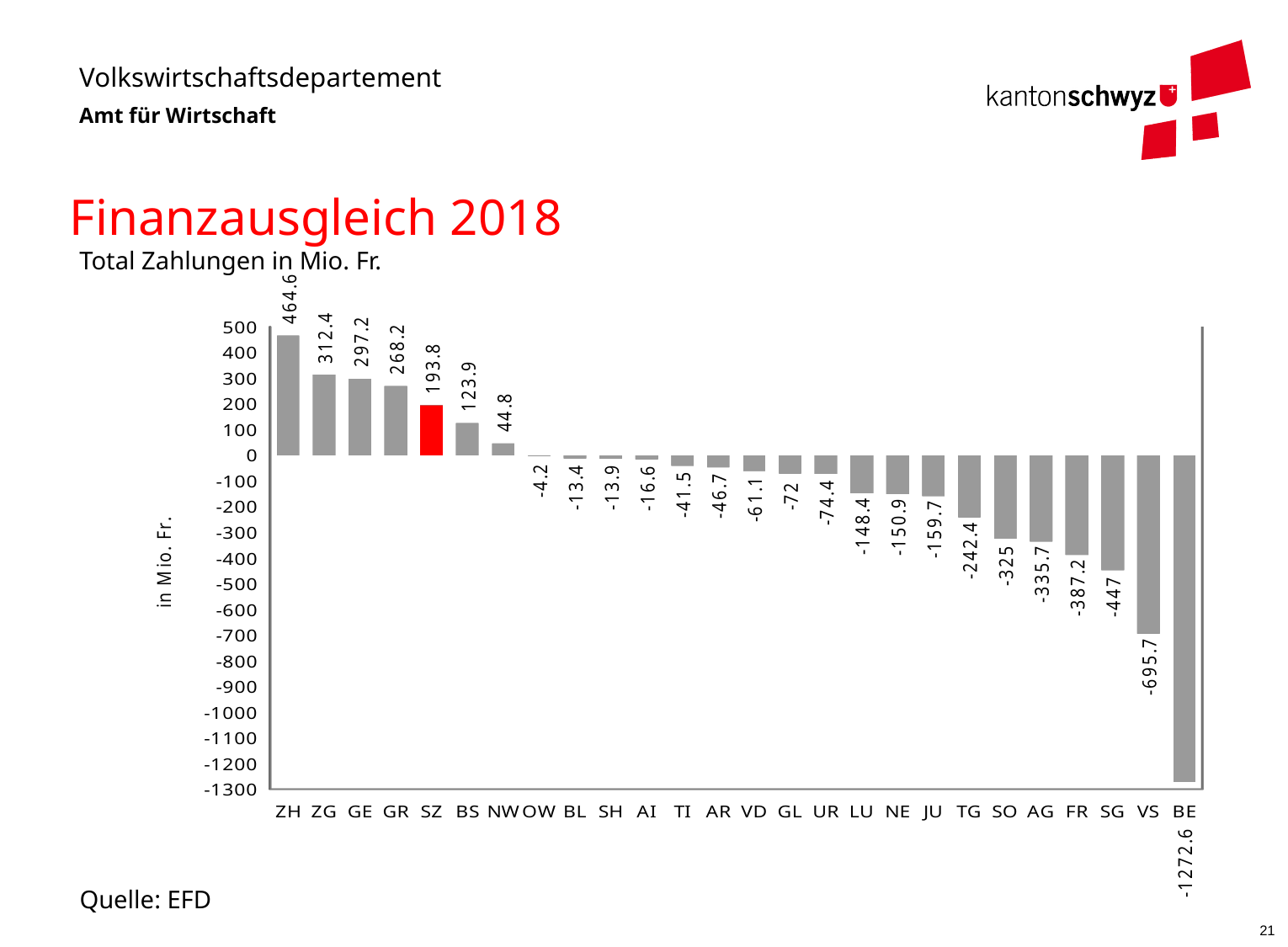
What is the value for VS? -695.7 Which canton has the lowest value? BE What is the value for BE? -1272.6 What kind of chart is shown? Bar chart Do the values rise or fall from left to right along the x axis? Fall Which bar is highlighted in red? SZ What is the value for SZ? 193.8 Which is larger, the value for GE or the value for GR? GE What is the label on the y axis? in Mio. Fr. What is the difference between the values for ZH and ZG? 152.2 Which canton has the highest value? ZH How many cantons are shown on the x axis? 26